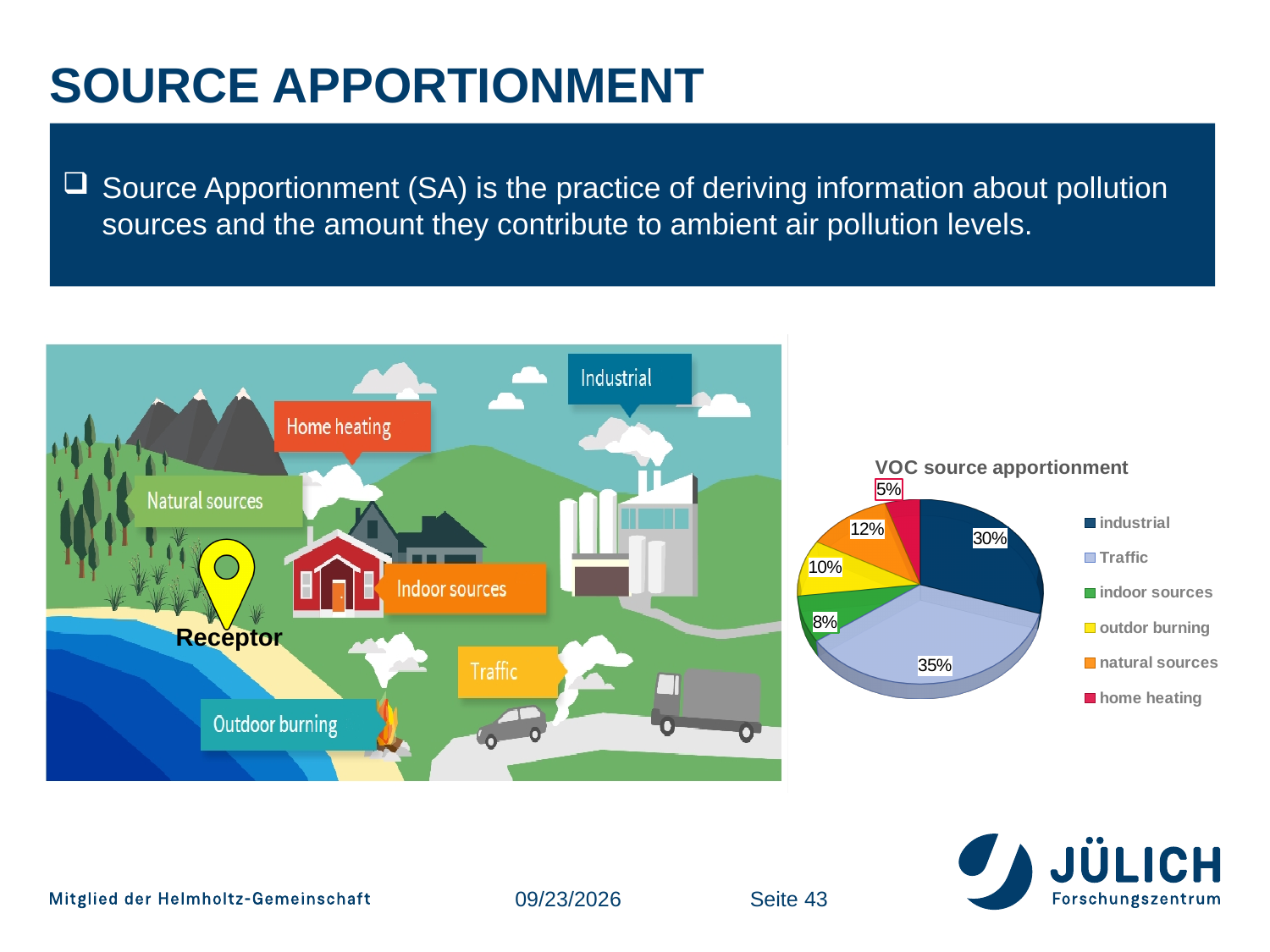
In the VOC source apportionment pie chart, what share do indoor sources have? 8% How many sources are listed in the legend of the VOC source apportionment pie chart? 6 In the VOC source apportionment pie chart, what share does industrial have? 30% In the VOC source apportionment pie chart, what colour is the Traffic slice? light blue In the VOC source apportionment pie chart, which is larger: natural sources or outdoor burning? natural sources In the VOC source apportionment pie chart, what is the difference between the Traffic share and the industrial share? 5% In the VOC source apportionment pie chart, what share does Traffic have? 35% What is the title of the pie chart? VOC source apportionment In the VOC source apportionment pie chart, what share does home heating have? 5% Which source has the smallest share in the VOC source apportionment pie chart? home heating What type of chart is used to show the VOC source apportionment? pie chart Which source has the largest share in the VOC source apportionment pie chart? Traffic